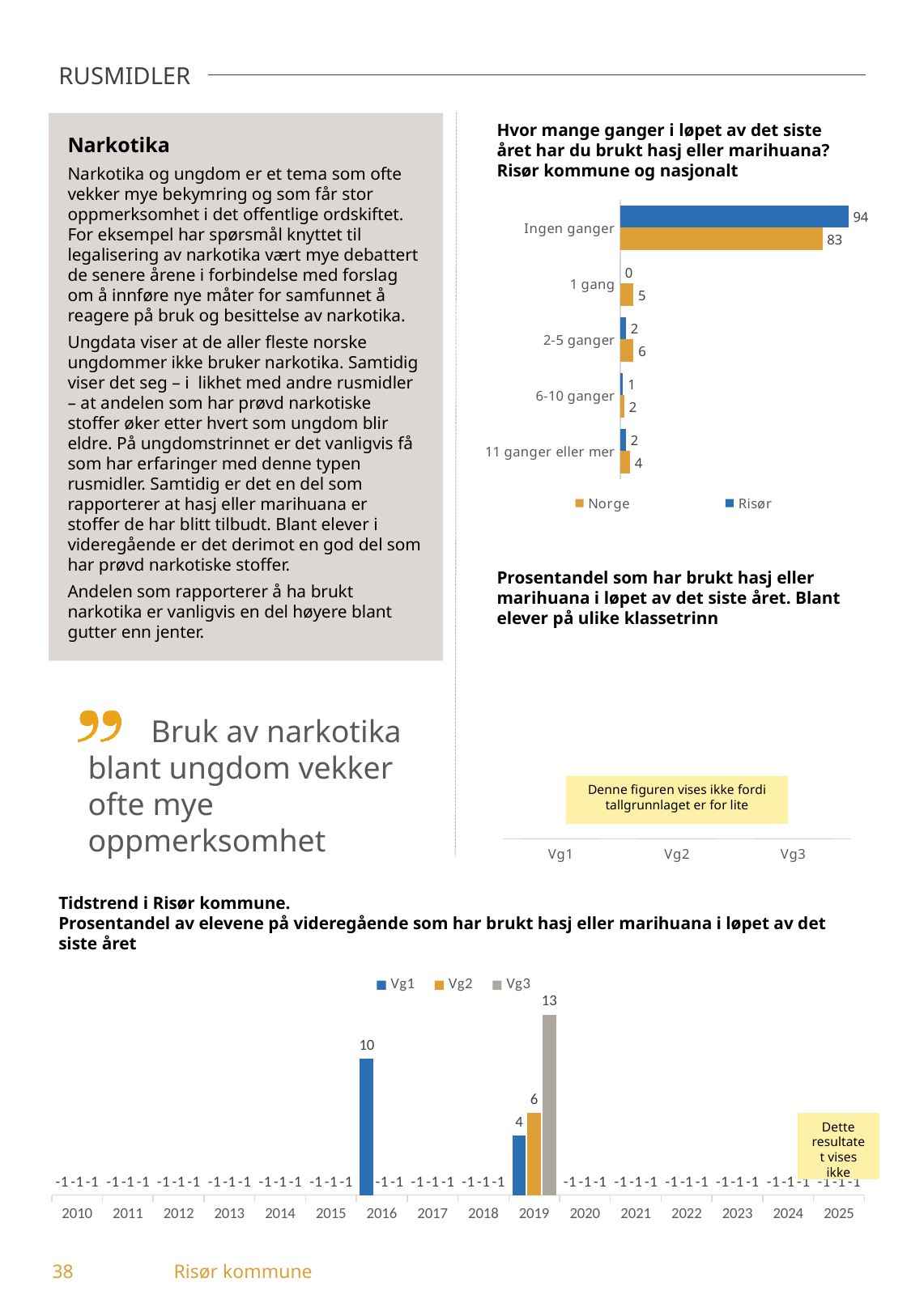
In the chart 'Hvor mange ganger i løpet av det siste året har du brukt hasj eller marihuana?', how many categories are shown? 5 In the chart 'Hvor mange ganger i løpet av det siste året har du brukt hasj eller marihuana?', what is the value for Norge in the '2-5 ganger' category? 6 In the chart 'Tidstrend i Risør kommune', what is the difference between Vg2 and Vg1 in 2019? 2 In the chart 'Tidstrend i Risør kommune', which series has the highest value in 2019? Vg3 In the chart 'Tidstrend i Risør kommune', what is the value for Vg3 in 2019? 13 In the chart 'Hvor mange ganger i løpet av det siste året har du brukt hasj eller marihuana?', how many series does the legend list? 2 What kind of chart is 'Hvor mange ganger i løpet av det siste året har du brukt hasj eller marihuana?'? Bar chart In the chart 'Hvor mange ganger i løpet av det siste året har du brukt hasj eller marihuana?', what is the difference between Risør and Norge for 'Ingen ganger'? 11 In the chart 'Tidstrend i Risør kommune', what is the value for Vg1 in 2016? 10 In the chart 'Hvor mange ganger i løpet av det siste året har du brukt hasj eller marihuana?', what is the value for Norge in the 'Ingen ganger' category? 83 In the chart 'Hvor mange ganger i løpet av det siste året har du brukt hasj eller marihuana?', what is the value for Risør in the 'Ingen ganger' category? 94 In the chart 'Hvor mange ganger i løpet av det siste året har du brukt hasj eller marihuana?', which category has the highest value for Norge? Ingen ganger